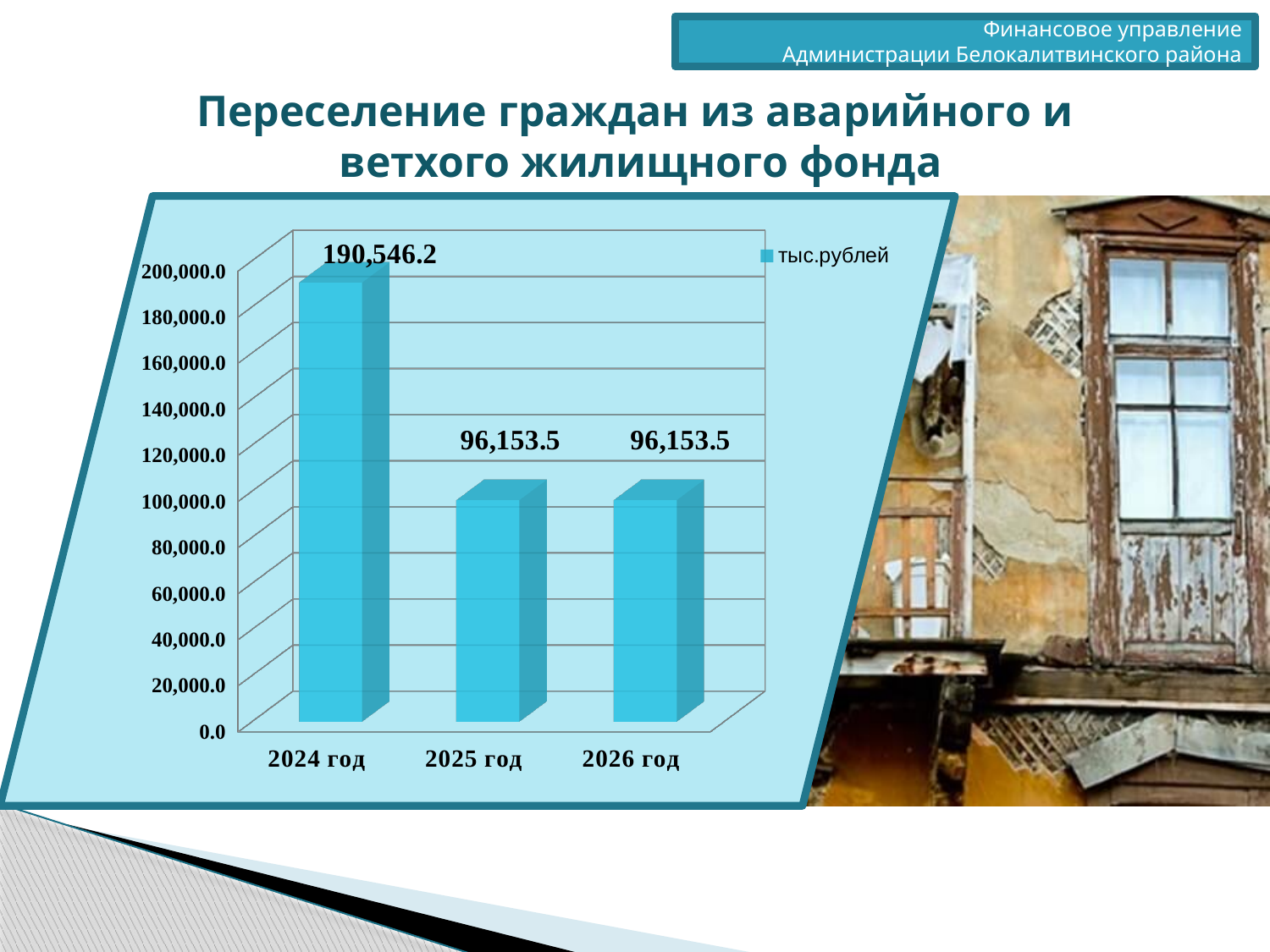
Is the value for 2024 год greater or less than 180,000.0? greater What kind of chart is shown on the slide? bar chart What is the value for 2024 год? 190,546.2 What is the difference between the values for 2024 год and 2025 год? 94,392.7 Is the value for 2025 год greater or less than 100,000.0? less How many years are shown on the x axis? 3 Does the value rise or fall from 2024 год to 2025 год? fall How many series does the legend list? 1 Which year has the highest value? 2024 год Which is larger, the value for 2024 год or the value for 2026 год? 2024 год What is the value for 2026 год? 96,153.5 What is the value for 2025 год? 96,153.5